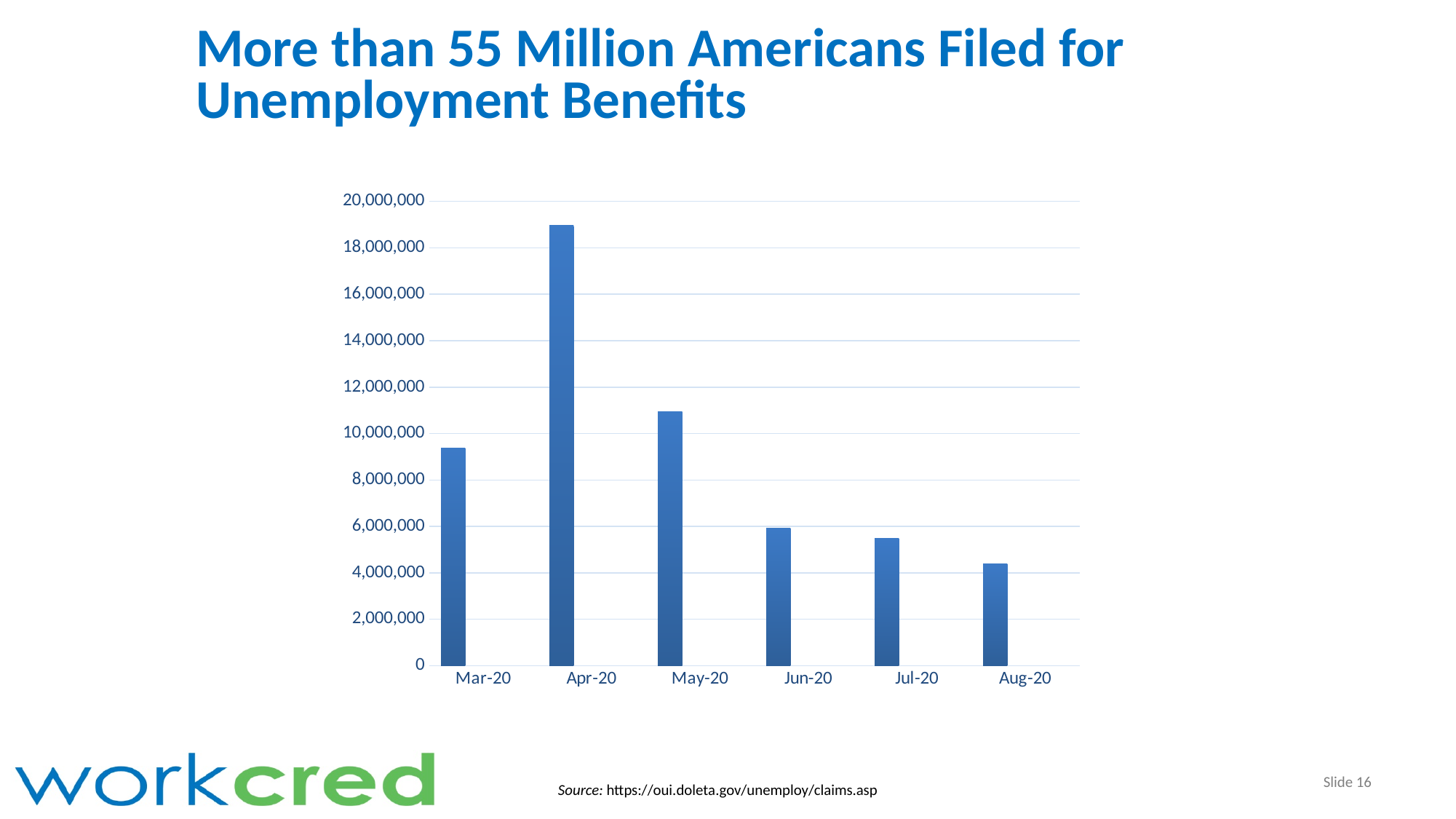
Which is larger, the value for Mar-20 or the value for May-20? May-20 Do the values rise or fall from Apr-20 to Aug-20? Fall Which month has the lowest bar in the chart? Aug-20 Is the value for Jul-20 greater or less than 4,000,000? greater How many months are shown on the x axis of the chart? 6 Is the value for Mar-20 greater or less than 10,000,000? less Which month has the highest bar in the chart? Apr-20 Is the value for Apr-20 greater or less than 18,000,000? greater What is the title of the slide containing the chart? More than 55 Million Americans Filed for Unemployment Benefits What kind of chart is shown on the slide? Bar chart